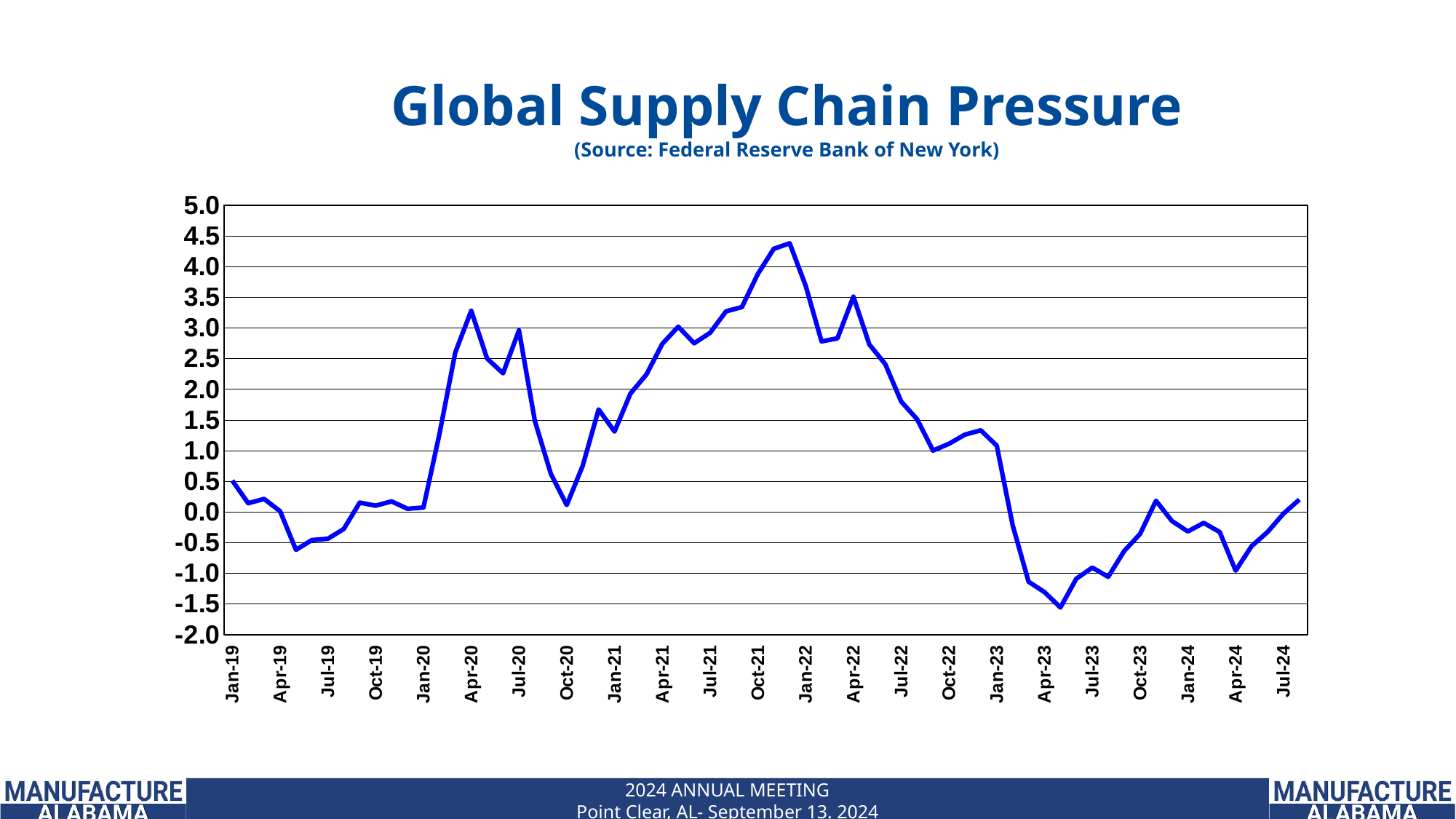
Is the value for Jul-22 greater or less than 1.5? greater How many date labels are shown on the x axis? 23 Is the value for Jul-19 greater or less than 0.0? less Is the value for Oct-21 greater or less than 3.5? greater What kind of chart is shown on the slide? line chart What source is cited for the chart? Federal Reserve Bank of New York Does the line rise or fall between Jan-22 and Apr-23? fall What is the title of the chart? Global Supply Chain Pressure Which is larger, the value for Apr-20 or the value for Apr-23? Apr-20